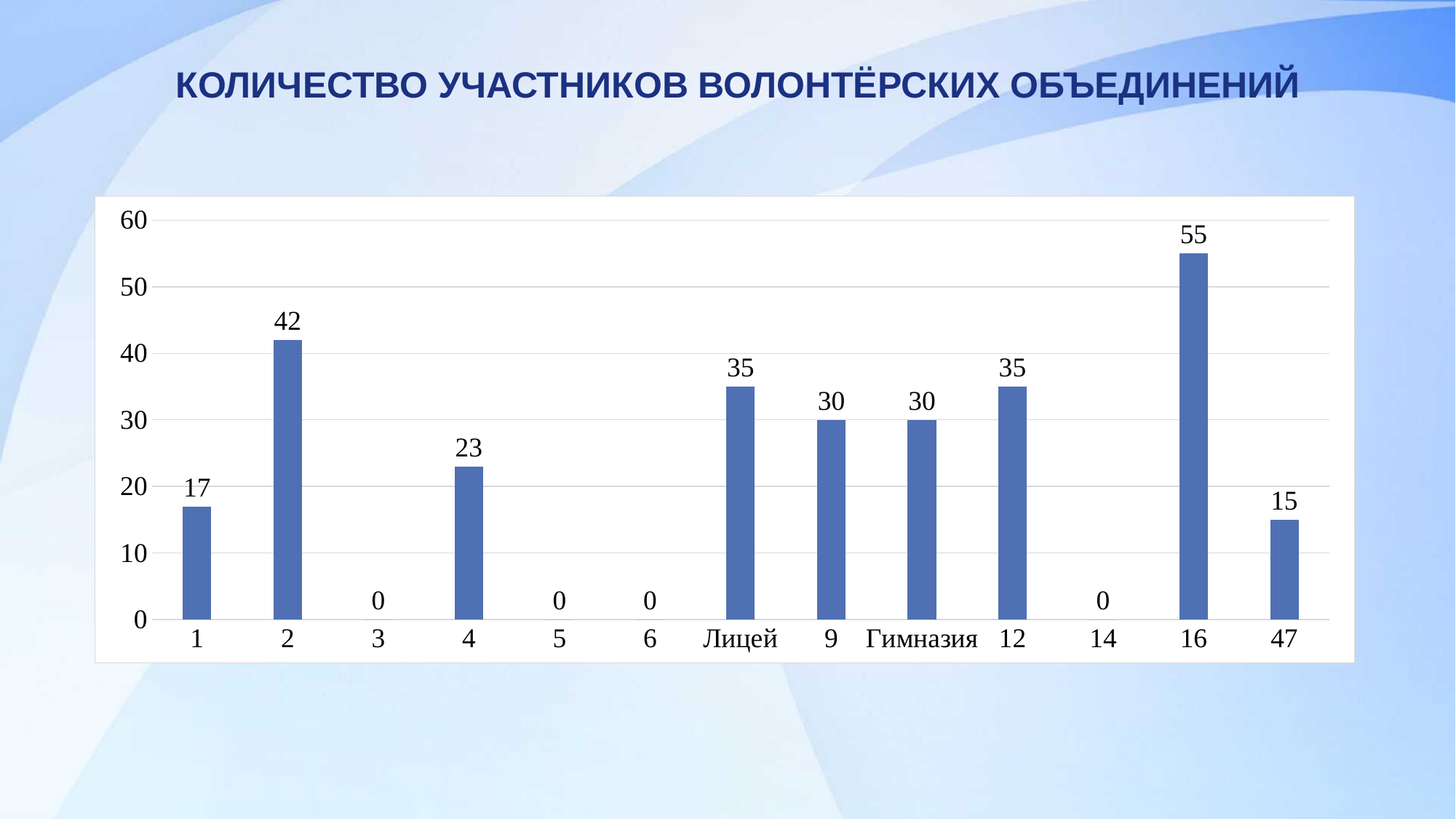
What is the difference between the values for category 4 and category 1? 6 Which category has the highest value? 16 What is the difference between the values for category 16 and category 2? 13 What is the value for Гимназия? 30 What is the value for category 47? 15 How many categories are shown on the x axis? 13 How many categories have a value of 0? 4 What is the value for Лицей? 35 What kind of chart is shown on the slide? Bar chart Which is larger, the value for category 9 or the value for category 12? 12 What is the value for category 2? 42 What is the title of the slide? КОЛИЧЕСТВО УЧАСТНИКОВ ВОЛОНТЁРСКИХ ОБЪЕДИНЕНИЙ